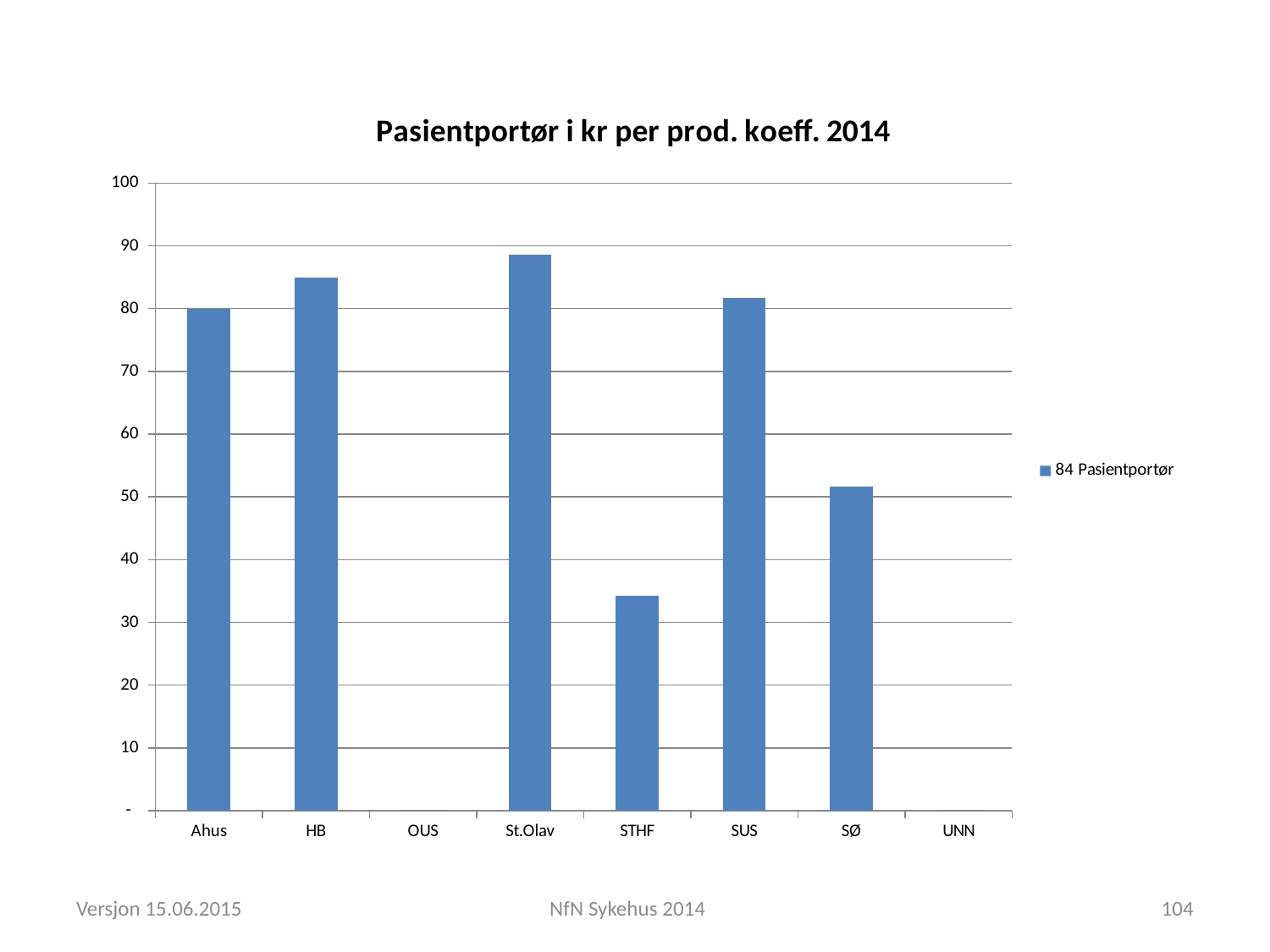
What is the legend entry for the series? 84 Pasientportør Is the value for HB greater or less than 80? greater Which category has the highest bar? St.Olav How many categories are shown on the x axis? 8 Is the value for St.Olav greater or less than 90? less Among the categories with a visible bar, which has the lowest value? STHF How many series does the legend list? 1 Is the value for STHF greater or less than 40? less Which is larger, the value for SUS or the value for SØ? SUS What is the title of the chart? Pasientportør i kr per prod. koeff. 2014 What kind of chart is shown on the slide? bar chart